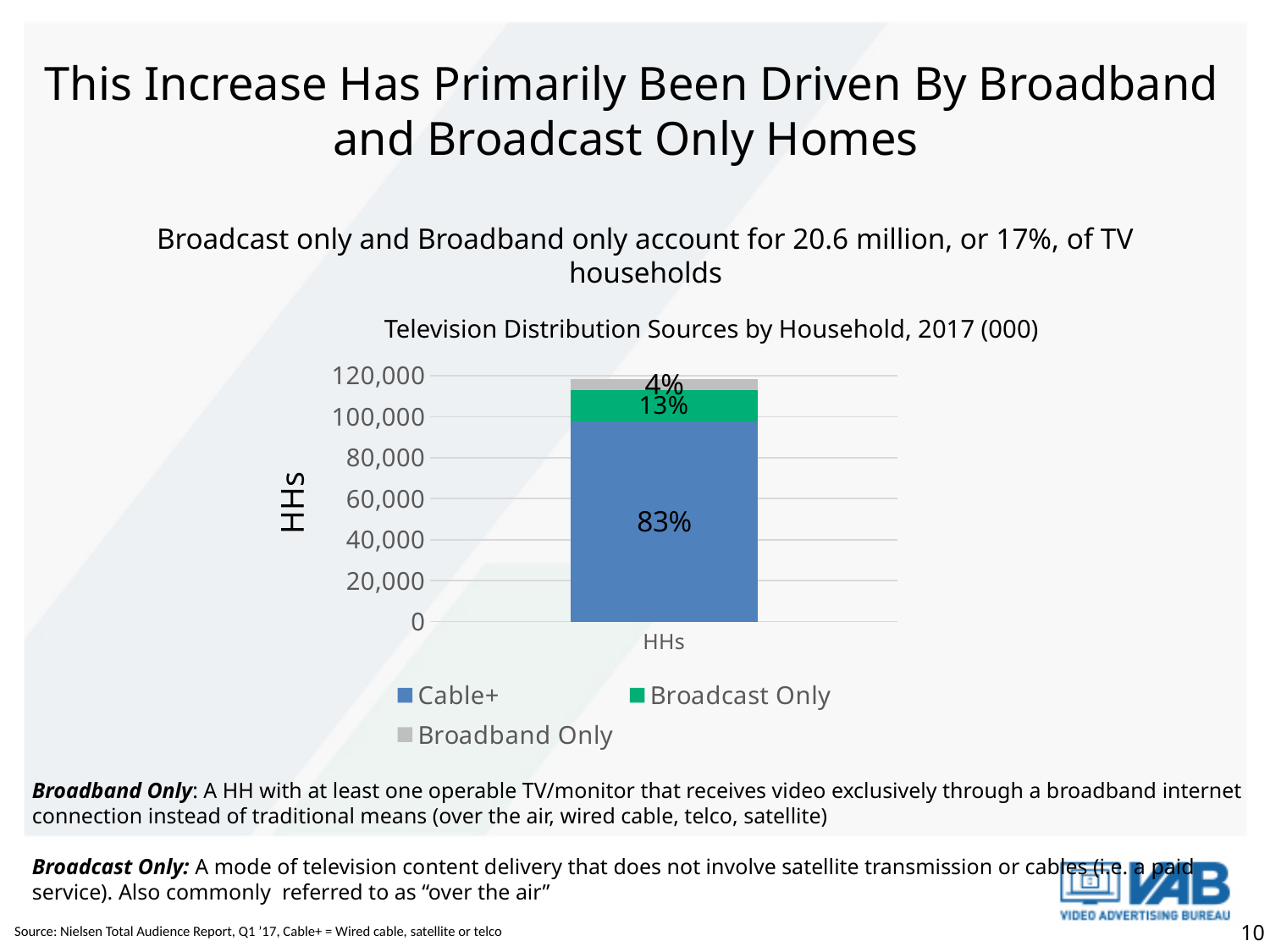
What percentage does the Cable+ segment show in the Television Distribution Sources by Household chart? 83% What is the difference in percentage points between the Cable+ share and the Broadcast Only share? 70% What is the difference in percentage points between the Broadcast Only share and the Broadband Only share? 9% What percentage does the Broadband Only segment show? 4% Which series accounts for the smallest share of the stacked bar? Broadband Only Which is larger, the Broadcast Only share or the Broadband Only share? Broadcast Only How many bars are plotted in the chart? 1 Which series accounts for the largest share of the stacked bar? Cable+ What kind of chart is shown on the slide? Stacked bar chart How many series does the legend list? 3 Is the total height of the HHs bar greater or less than 100,000? greater What percentage does the Broadcast Only segment show? 13%